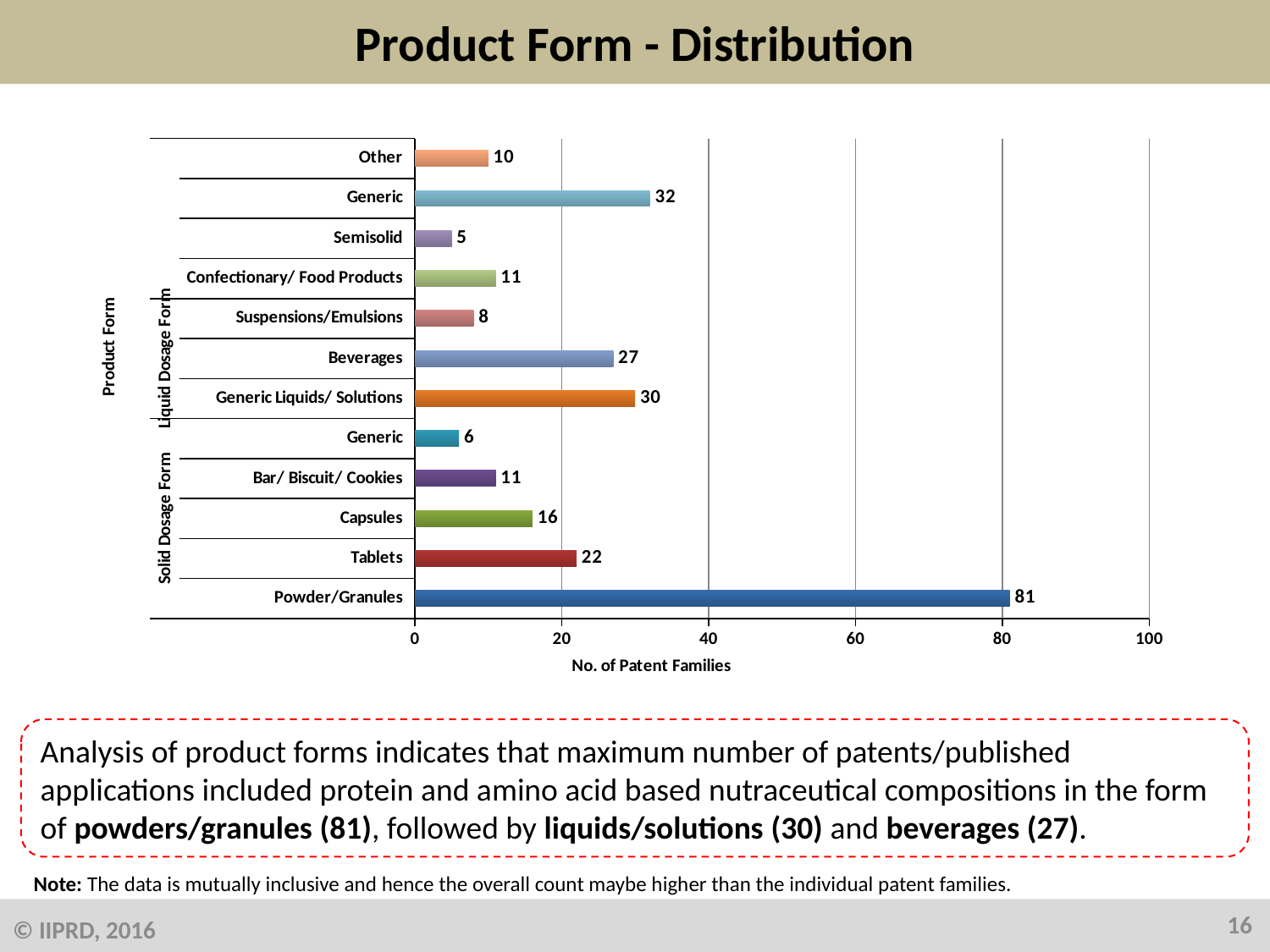
What is the number of patent families for Powder/Granules? 81 What is the number of patent families for Semisolid? 5 Which product form has the lowest number of patent families? Semisolid What is the number of patent families for Capsules? 16 Which product form has the highest number of patent families? Powder/Granules Which has more patent families, Tablets or Capsules? Tablets What is the label of the horizontal axis of the chart? No. of Patent Families What is the difference in patent families between Generic Liquids/ Solutions and Beverages? 3 What is the difference in patent families between Powder/Granules and Tablets? 59 What type of chart is shown on the slide? Bar chart What is the number of patent families for Beverages? 27 How many product form categories are plotted in the chart? 12